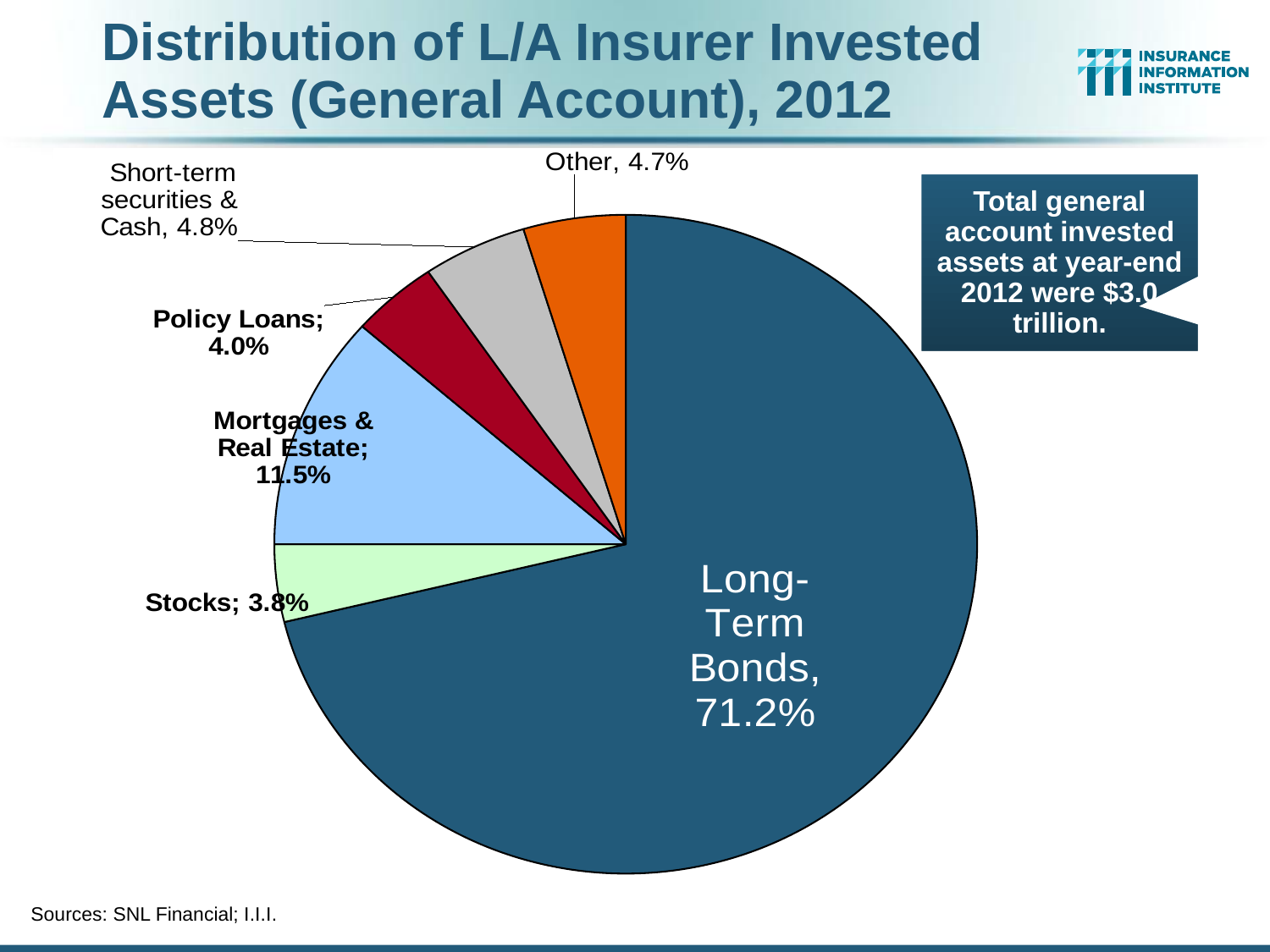
What share of invested assets is in Long-Term Bonds? 71.2% What share of invested assets is in Policy Loans? 4.0% Which category has the smallest share of invested assets? Stocks According to the callout box, what were total general account invested assets at year-end 2012? $3.0 trillion What share of invested assets is in Short-term securities & Cash? 4.8% What share of invested assets is in Stocks? 3.8% Which is larger, the share for Other or the share for Policy Loans? Other What kind of chart is shown on the slide? Pie chart How many slices does the pie chart have? 6 Which category has the largest share of invested assets? Long-Term Bonds What share of invested assets is in Mortgages & Real Estate? 11.5% What is the difference in percentage points between Long-Term Bonds and Mortgages & Real Estate? 59.7